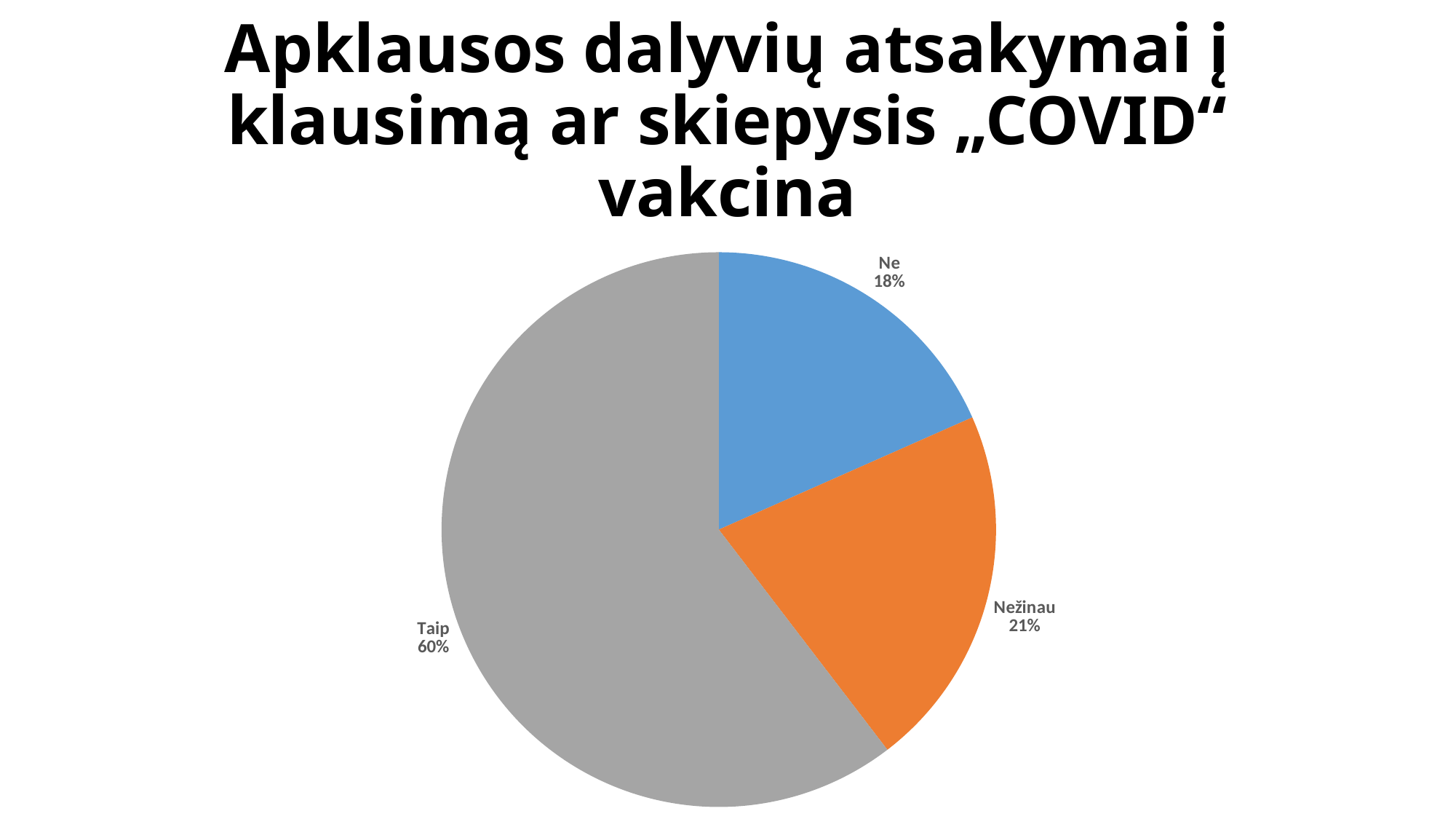
What is the difference in percentage points between "Taip" and "Nežinau"? 39 What colour is the "Taip" slice? grey Which is larger, the share for "Ne" or the share for "Nežinau"? Nežinau What share of respondents answered "Taip"? 60% What share of respondents answered "Ne"? 18% What colour is the "Ne" slice? blue What is the difference in percentage points between "Nežinau" and "Ne"? 3 Which answer has the largest share of the pie? Taip How many slices does the pie chart have? 3 What kind of chart is shown on the slide? pie chart What share of respondents answered "Nežinau"? 21% Which answer has the smallest share of the pie? Ne